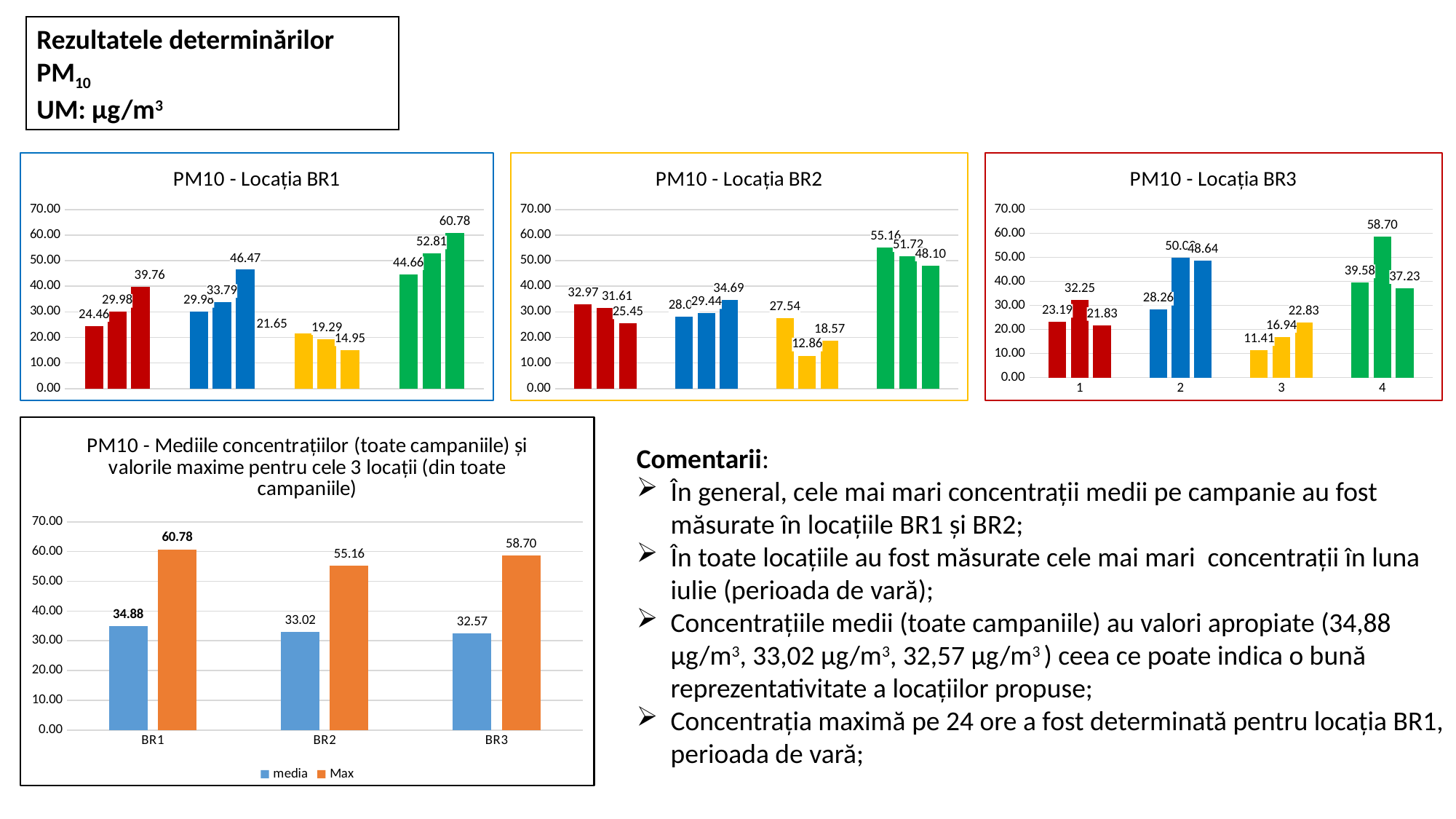
In the bottom-left chart, which is larger: the 'Max' value for BR2 or the 'Max' value for BR3? Max for BR3 In the chart titled 'PM10 - Mediile concentrațiilor (toate campaniile) și valorile maxime pentru cele 3 locații', what is the 'media' value for BR1? 34.88 In the bottom-left chart, which location has the highest 'Max' value? BR1 What kind of chart is 'PM10 - Locația BR3'? Bar chart In the chart 'PM10 - Locația BR1', what is the highest value shown? 60.78 In the chart 'PM10 - Locația BR3', is the tallest bar in category 2 greater or less than 40.00? greater In the bottom-left chart, what is the 'Max' value for BR3? 58.70 How many series does the legend of the bottom-left chart list? 2 In the bottom-left chart, what is the difference between the 'Max' and 'media' values for BR2? 22.14 In the chart 'PM10 - Locația BR2', what is the lowest value shown? 12.86 In the chart 'PM10 - Locația BR3', how many categories are shown on the x axis? 4 In the bottom-left chart, which location has the lowest 'media' value? BR3